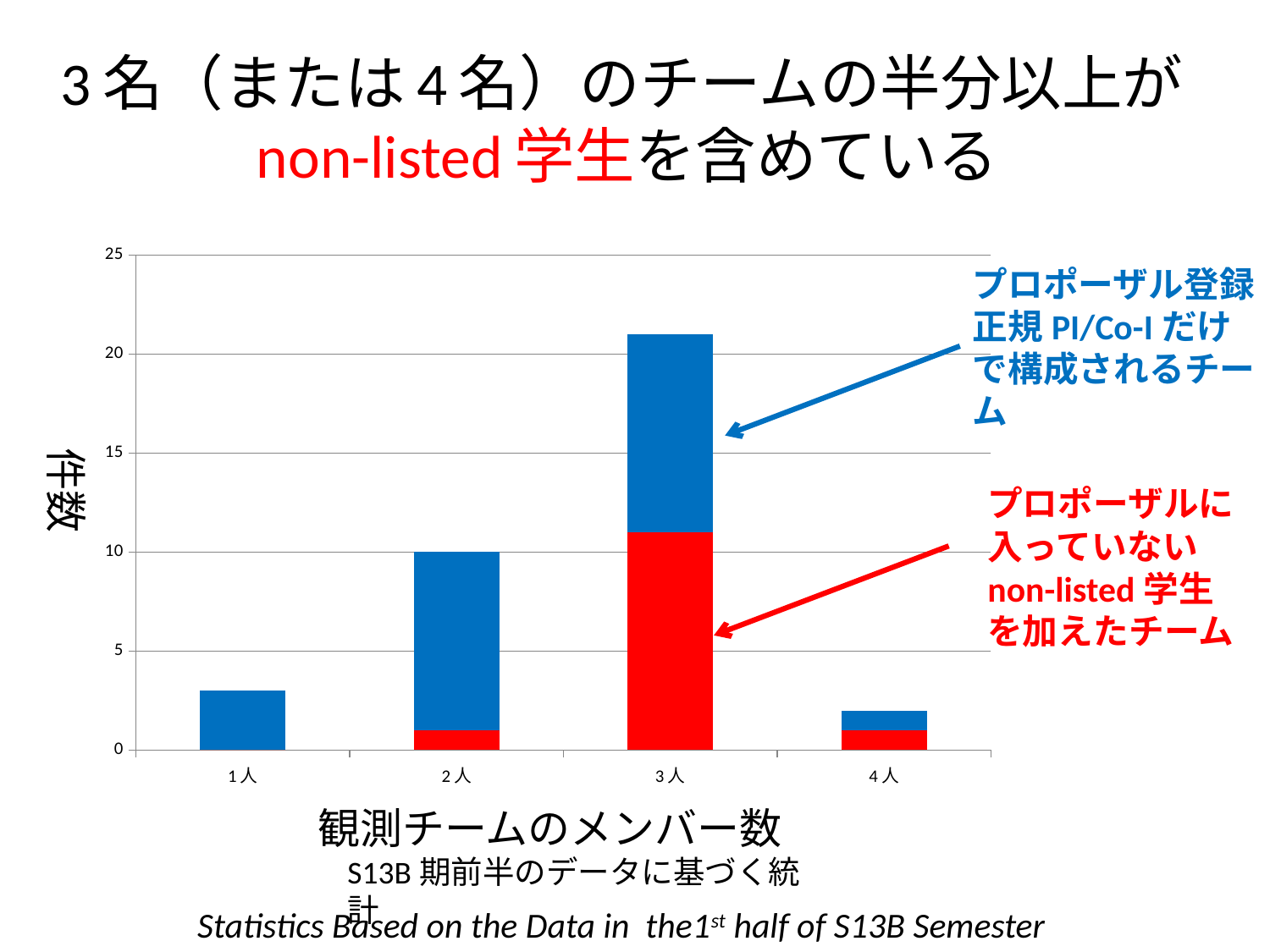
Is the red portion of the bar for 3人 greater or less than 5? greater How many categories are shown on the x axis of the chart? 4 Which bar is taller, 2人 or 3人? 3人 What kind of chart is shown on the slide? stacked bar chart Is the red portion of the bar for 2人 greater or less than 5? less Is the total value for 4人 greater or less than 5? less What is the title of the x axis of the chart? 観測チームのメンバー数 Which category has the tallest bar in the chart? 3人 Which colour represents teams that include non-listed students? red What is the total height of the bar for 2人? 10